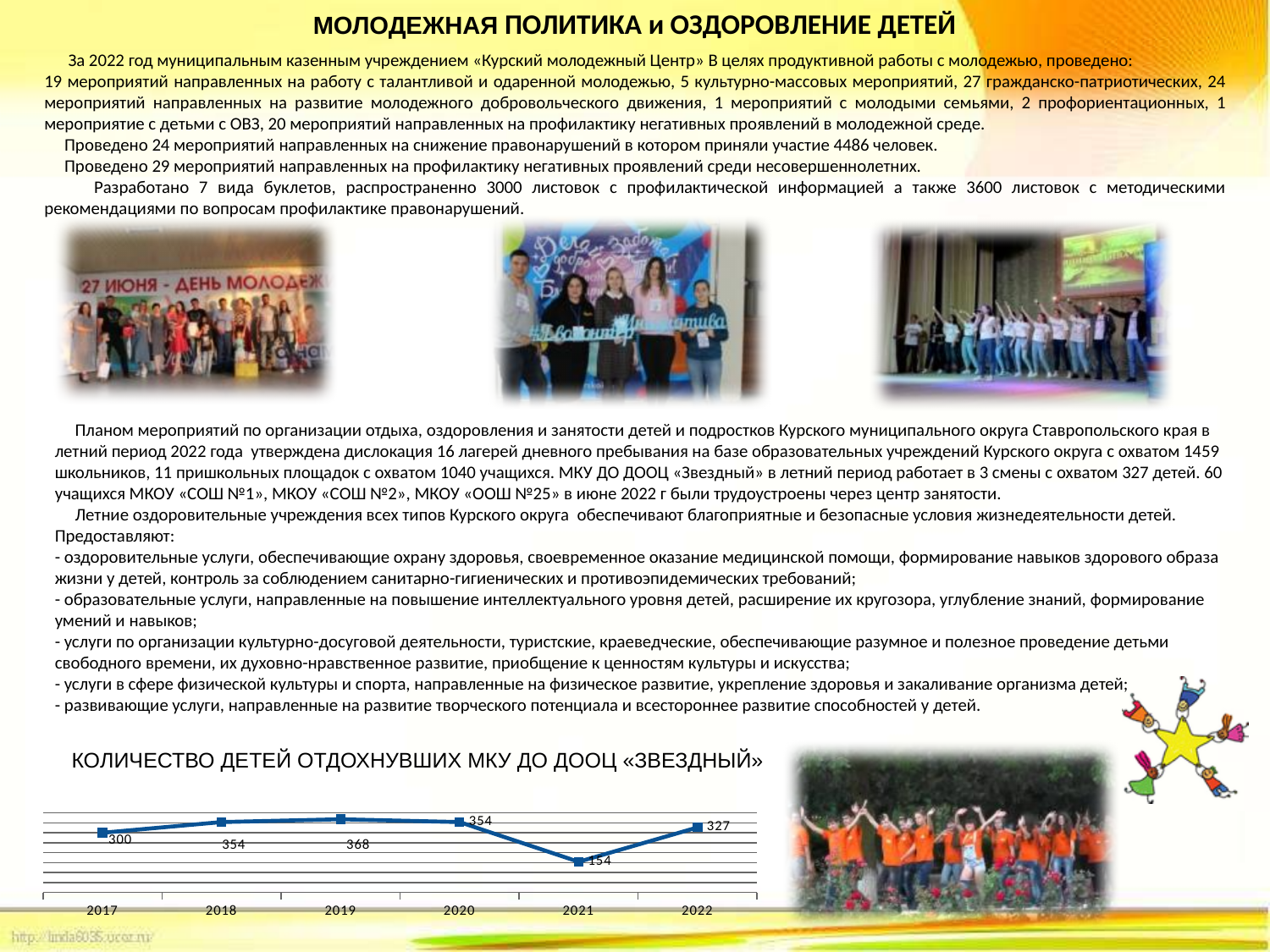
Which year has the lowest value in the chart? 2021 What is the value for 2022 in the chart? 327 What is the value for 2021 in the chart? 154 What kind of chart is shown on the slide? line chart What is the value for 2019 in the chart? 368 Do the values rise or fall from 2019 to 2021? fall How many years are plotted in the chart? 6 Which year has the highest value in the chart? 2019 What is the value for 2017 in the chart? 300 What is the difference between the values for 2022 and 2017? 27 What is the difference between the values for 2019 and 2021? 214 Which is larger, the value for 2018 or the value for 2021? 2018